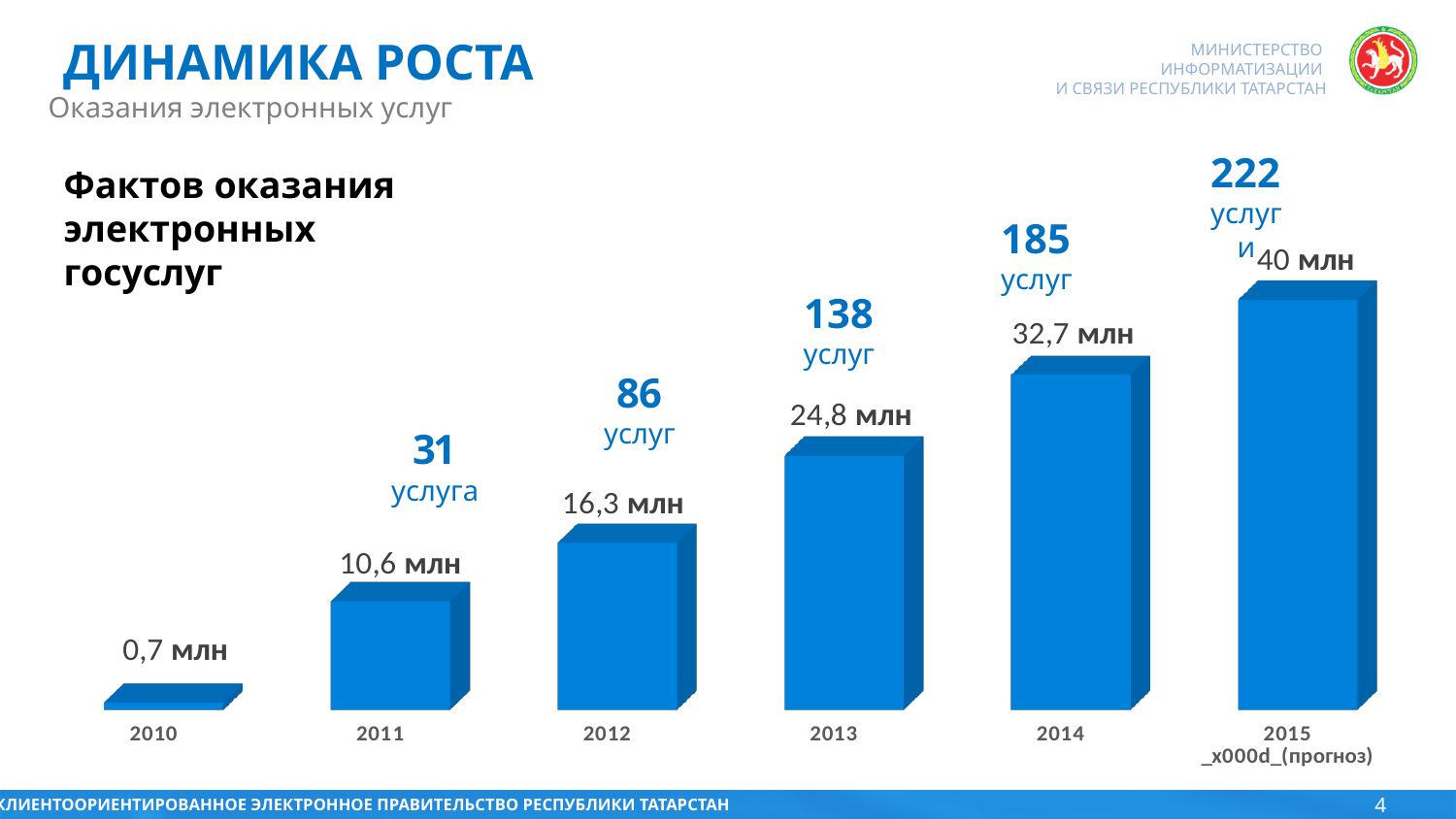
What kind of chart is shown on the slide? bar chart Do the values rise or fall from 2010 to 2015? rise What value is shown for 2015 (прогноз)? 40 млн How many услуг are indicated above the 2014 bar? 185 Which year has the highest value? 2015 What is the difference between the values for 2014 and 2013? 7,9 млн Which is larger, the value for 2012 or the value for 2013? 2013 What value is shown for 2013? 24,8 млн What is the difference between the values for 2012 and 2011? 5,7 млн How many years are shown on the x axis? 6 Which year has the lowest value? 2010 What value is shown for 2010? 0,7 млн